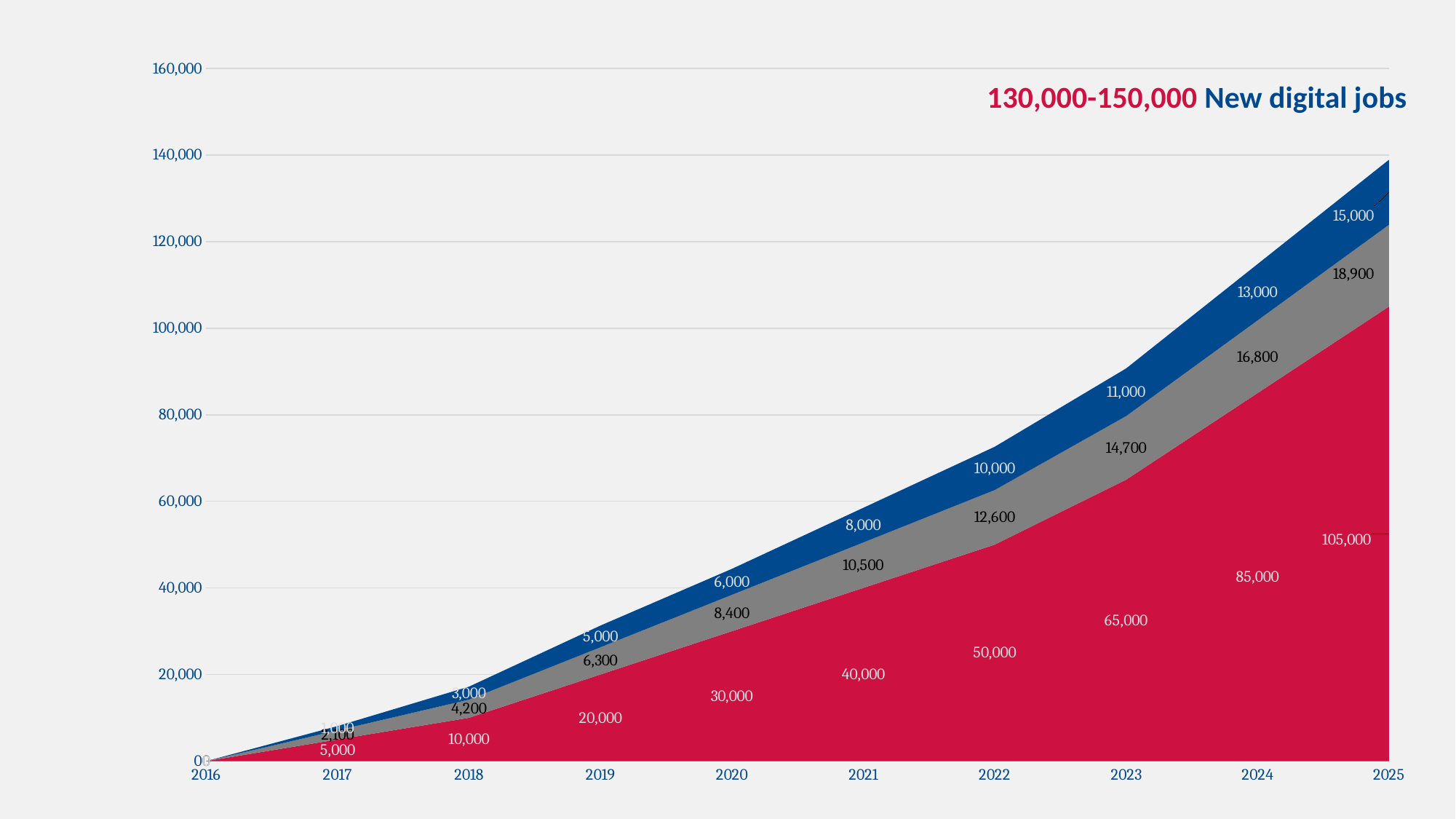
What kind of chart is shown on the slide? Stacked area chart Which is larger in 2024, the grey series or the blue series? Grey series What is the total of the three stacked series in 2025? 138,900 What is the value of the grey series in 2023? 14,700 What is the difference between the red series values in 2025 and 2024? 20,000 What is the value of the red series in 2025? 105,000 Do the values rise or fall from 2016 to 2025? Rise What is the value of the red series in 2019? 20,000 How many years are shown on the x axis? 10 What is the value of the blue series in 2021? 8,000 What text is shown in the top right of the chart? 130,000-150,000 New digital jobs In which year is the red series highest? 2025